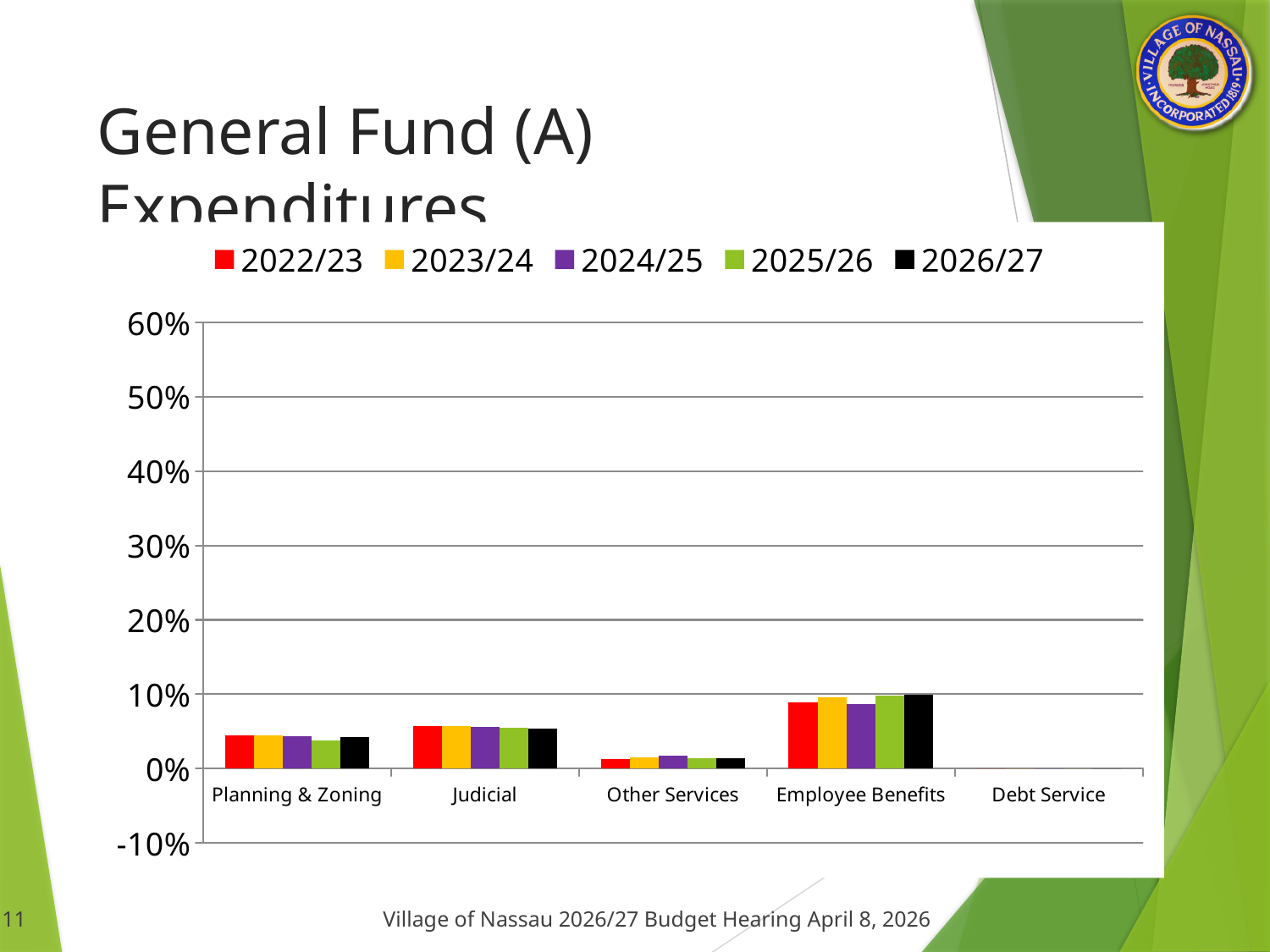
What kind of chart is shown on the slide? bar chart How many categories are shown on the x axis of the chart? 5 For 2026/27, which is larger: Judicial or Other Services? Judicial Which category has the lowest values in the chart? Debt Service What is the title of the chart on the slide? General Fund (A) Expenditures Which category has the highest bars in the chart? Employee Benefits For 2022/23, which is larger: Employee Benefits or Planning & Zoning? Employee Benefits How many series does the chart's legend list? 5 Is the value for Other Services in 2024/25 greater or less than 10%? less Is the value for Employee Benefits in 2026/27 greater or less than 20%? less Which colour represents the 2026/27 series in the chart's legend? black Is the value for Planning & Zoning in 2022/23 greater or less than 10%? less